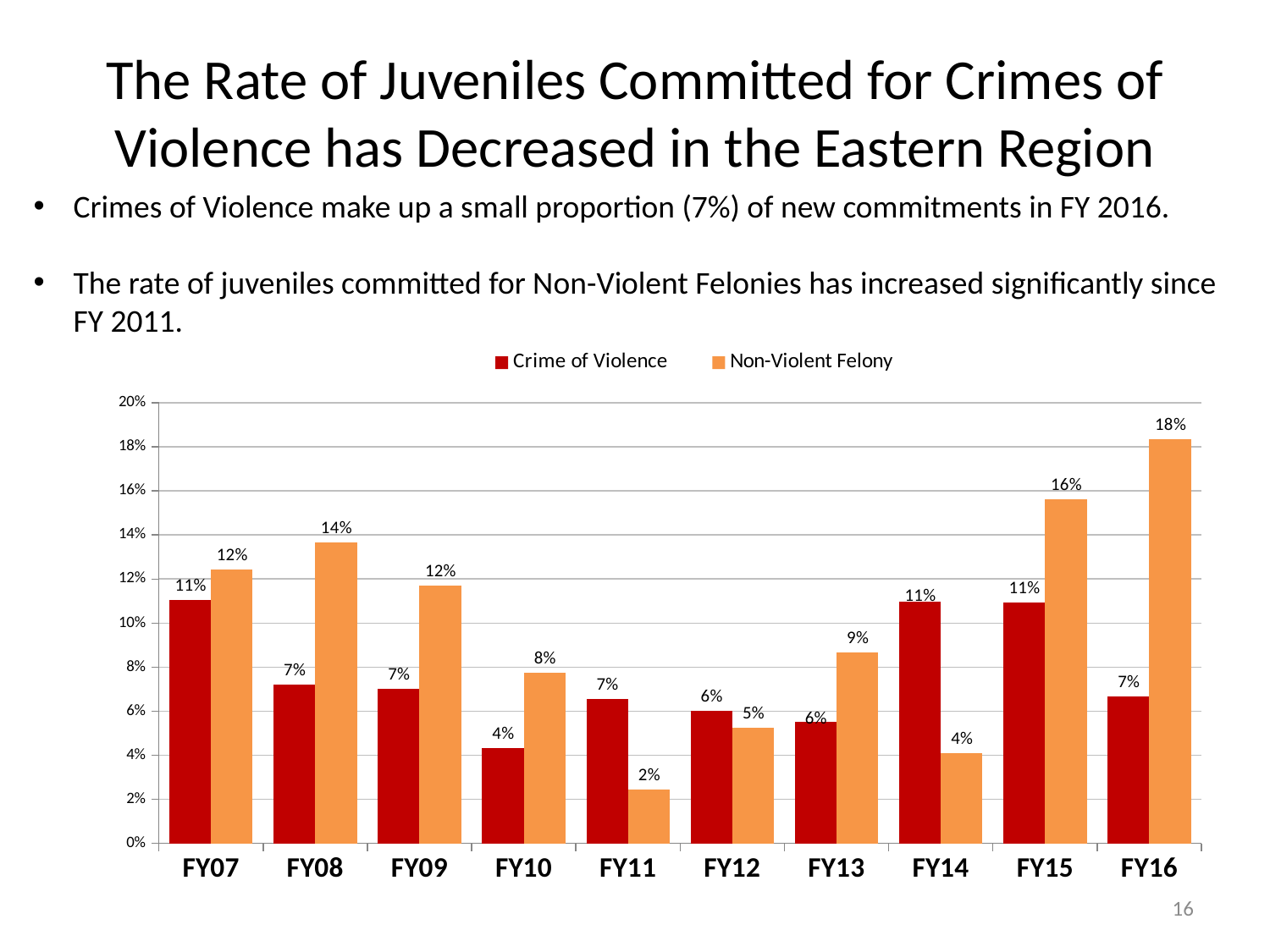
How many series does the legend list? 2 In which fiscal year is the Non-Violent Felony value lowest? FY11 What is the difference between the Non-Violent Felony and Crime of Violence values in FY16? 11 percentage points In which fiscal year is the Non-Violent Felony value highest? FY16 What is the value for Crime of Violence in FY10? 4% In which fiscal year is the Crime of Violence value lowest? FY10 What is the value for Non-Violent Felony in FY11? 2% How many fiscal years are shown on the x axis? 10 In FY11, which is larger: Crime of Violence or Non-Violent Felony? Crime of Violence What is the value for Non-Violent Felony in FY16? 18% What kind of chart is shown on the slide? bar chart Is the value for Non-Violent Felony in FY15 greater or less than 14%? greater